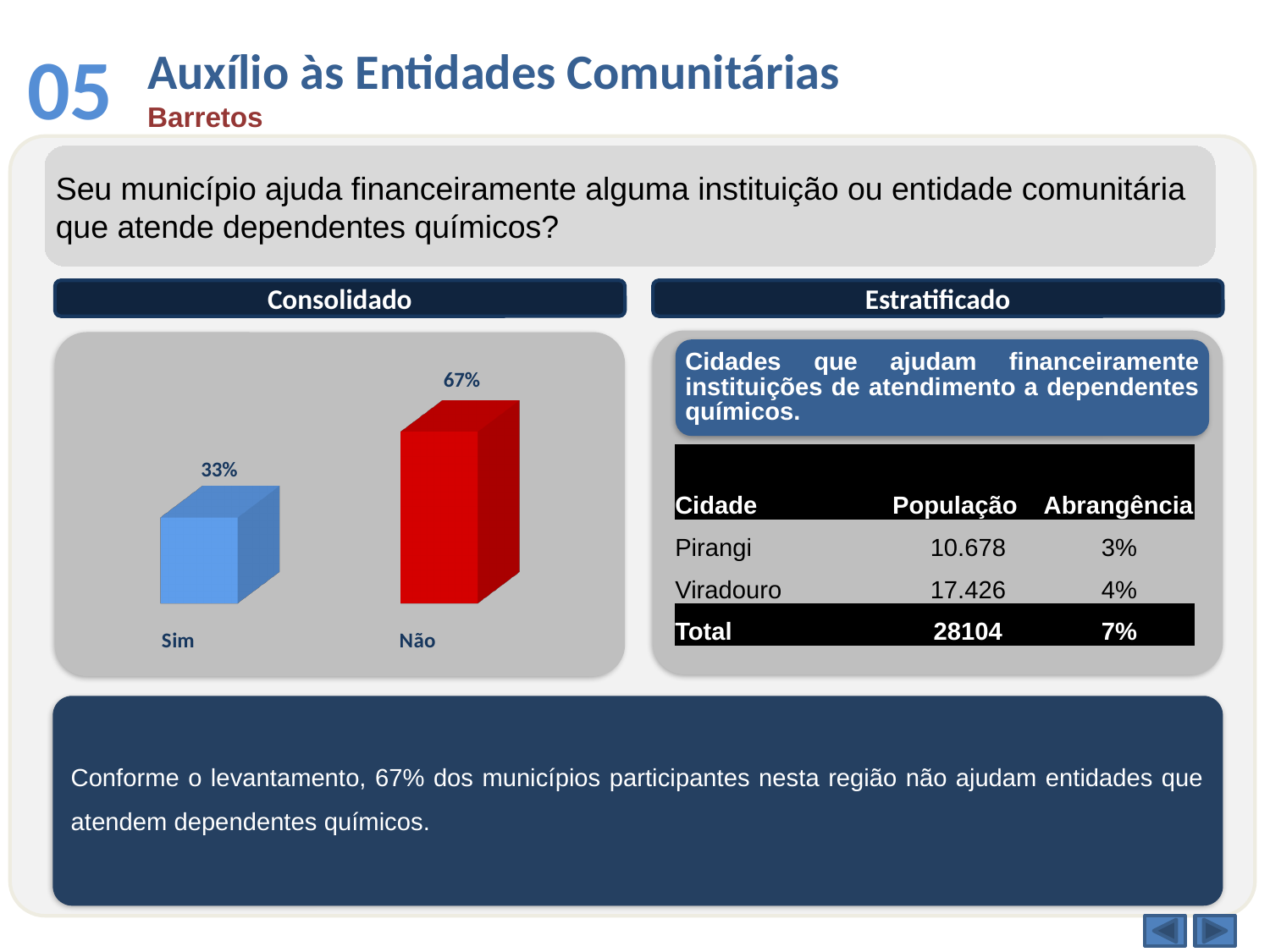
What kind of chart is shown under the Consolidado heading? Bar chart What is the difference between the values for "Não" and "Sim" in the Consolidado chart? 34% Which category has the lowest value in the Consolidado chart? Sim What is the total of the two values shown in the Consolidado chart? 100% What colour is the bar for "Não" in the Consolidado chart? Red In the Consolidado chart, which is larger: the value for "Sim" or the value for "Não"? Não What colour is the bar for "Sim" in the Consolidado chart? Blue What is the value for "Não" in the Consolidado chart? 67% How many categories are shown in the Consolidado chart? 2 What is the value for "Sim" in the Consolidado chart? 33% Which category has the highest value in the Consolidado chart? Não